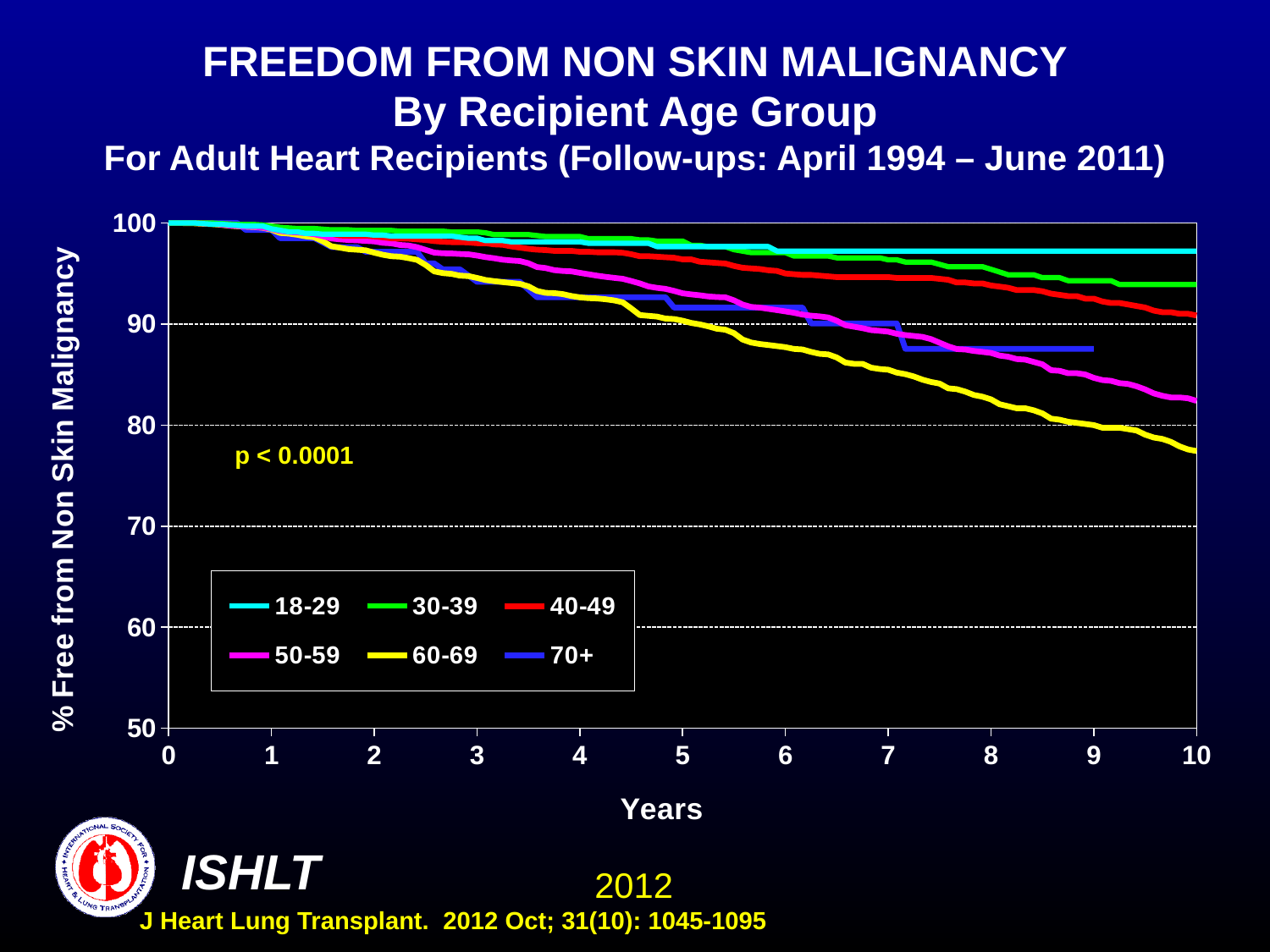
What p-value is printed on the chart? p < 0.0001 How many age groups does the legend list? 6 Which age group has the lowest freedom from non skin malignancy at 10 years? 60-69 What kind of chart is shown on the slide? line chart Is the value for the 50-59 age group at 10 years greater or less than 80? greater Is the value for the 18-29 age group at 10 years greater or less than 90? greater Is the value for the 60-69 age group at 10 years greater or less than 80? less At 8 years, which age group has the higher value: 30-39 or 50-59? 30-39 Which age group has the highest freedom from non skin malignancy at 10 years? 18-29 Do the values for the 60-69 age group rise or fall as years increase? fall What is the label of the x axis? Years